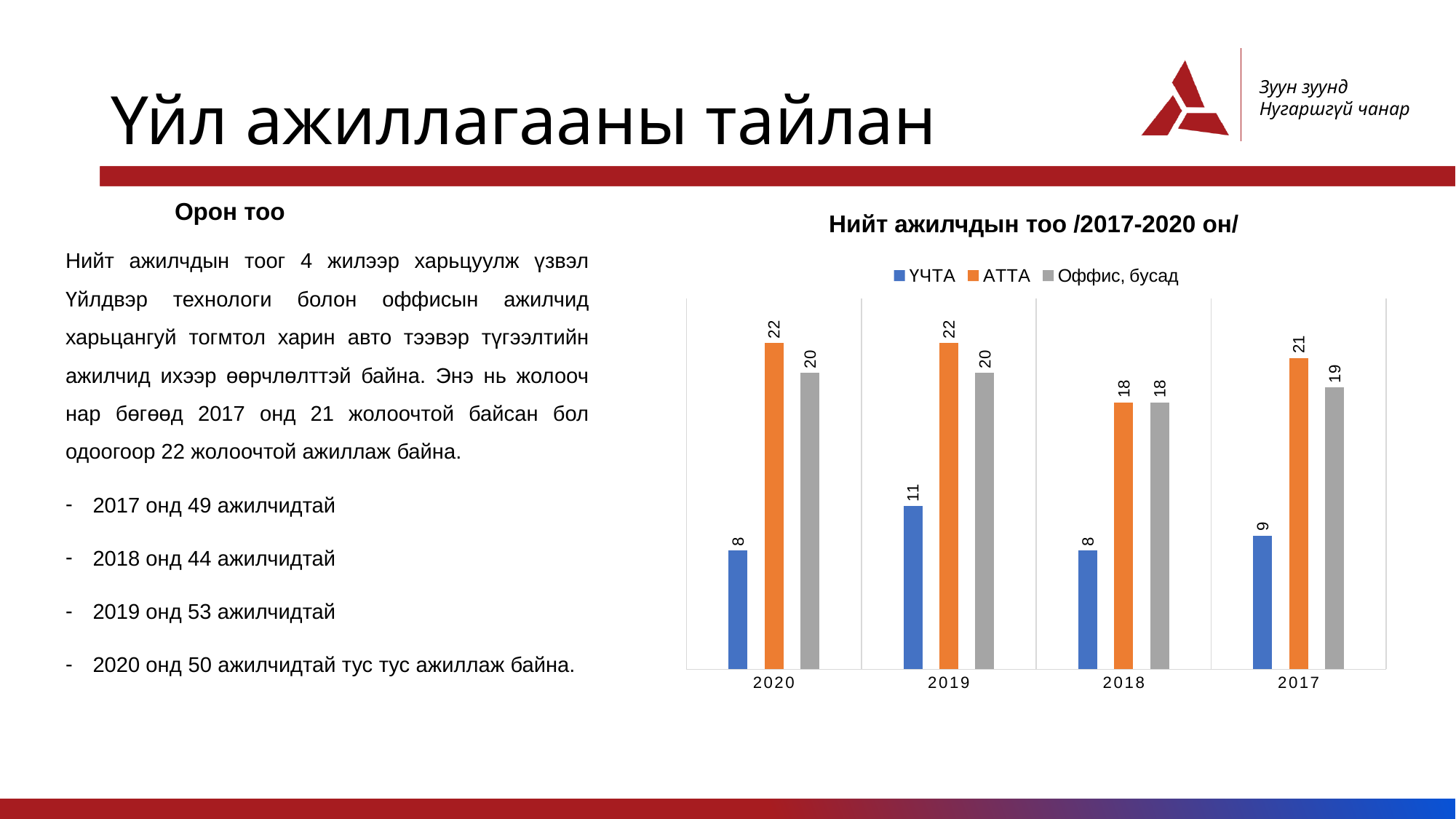
What kind of chart is shown on the slide? Bar chart How many series does the legend list? 3 What is the value for АТТА in 2018? 18 Which is larger in 2019: the АТТА value or the Оффис, бусад value? АТТА What is the value for УЧТА in 2019? 11 In which year is the УЧТА value highest? 2019 How many years are shown on the x axis? 4 In which year is the АТТА value lowest? 2018 What is the value for Оффис, бусад in 2017? 19 What is the title of the chart? Нийт ажилчдын тоо /2017-2020 он/ What is the difference between the АТТА and УЧТА values in 2017? 12 What is the value for АТТА in 2020? 22